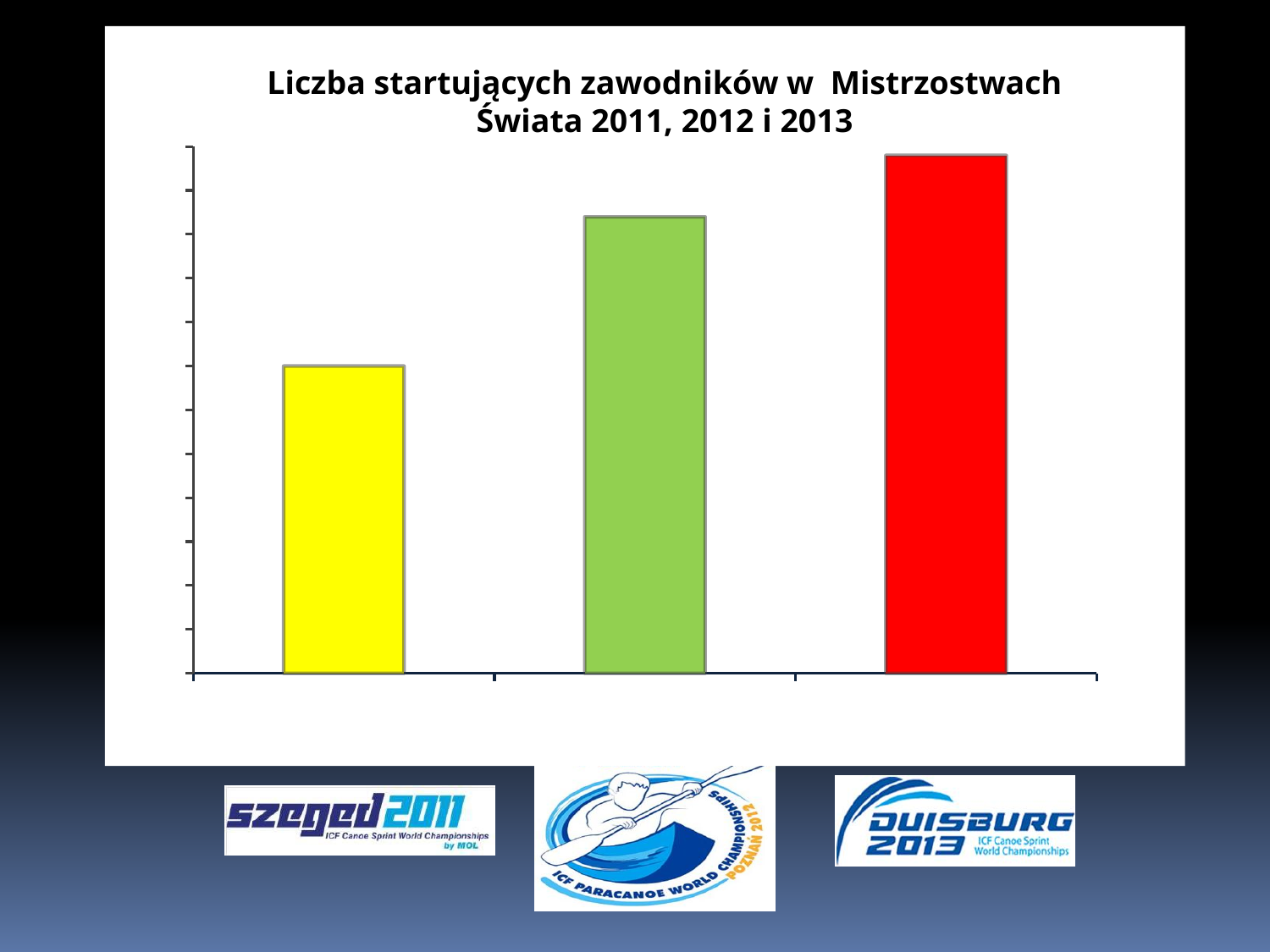
Which bar is the tallest in the chart: the yellow, the green or the red one? red What colour is the leftmost bar in the chart? yellow Do the bar heights rise or fall from left to right across the chart? rise Which bar is the shortest in the chart: the yellow, the green or the red one? yellow What kind of chart is shown on the slide? bar chart Is the red bar taller or shorter than the green bar? taller Which position, from left to right, does the tallest bar occupy? third (rightmost) Is the green bar taller or shorter than the yellow bar? taller What is the title of the chart? Liczba startujących zawodników w Mistrzostwach Świata 2011, 2012 i 2013 How many bars does the chart contain? 3